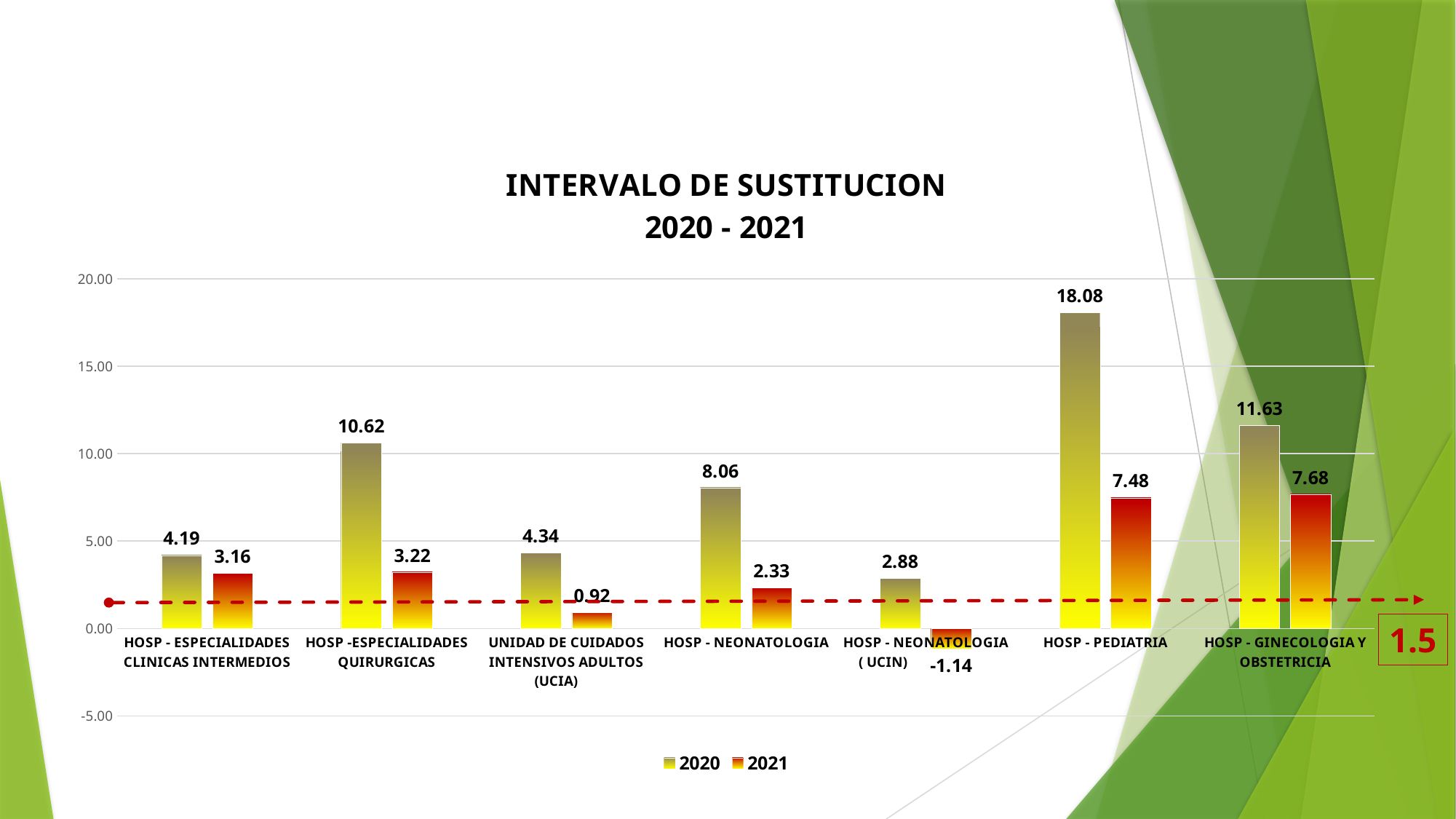
What kind of chart is shown on the slide? bar chart How many series does the legend list? 2 What is the 2020 value for HOSP - PEDIATRIA? 18.08 How many categories are shown on the x axis? 7 What is the 2021 value for HOSP - NEONATOLOGIA ( UCIN)? -1.14 Which is larger, the 2021 value for HOSP - PEDIATRIA or the 2021 value for HOSP - GINECOLOGIA Y OBSTETRICIA? HOSP - GINECOLOGIA Y OBSTETRICIA What value is marked by the red dashed horizontal line? 1.5 Which category has the highest 2020 value? HOSP - PEDIATRIA Which category has the lowest 2021 value? HOSP - NEONATOLOGIA ( UCIN) What is the 2021 value for UNIDAD DE CUIDADOS INTENSIVOS ADULTOS (UCIA)? 0.92 What is the difference between the 2020 and 2021 values for HOSP - PEDIATRIA? 10.60 Is the 2020 value for HOSP -ESPECIALIDADES QUIRURGICAS greater or less than 10.00? greater